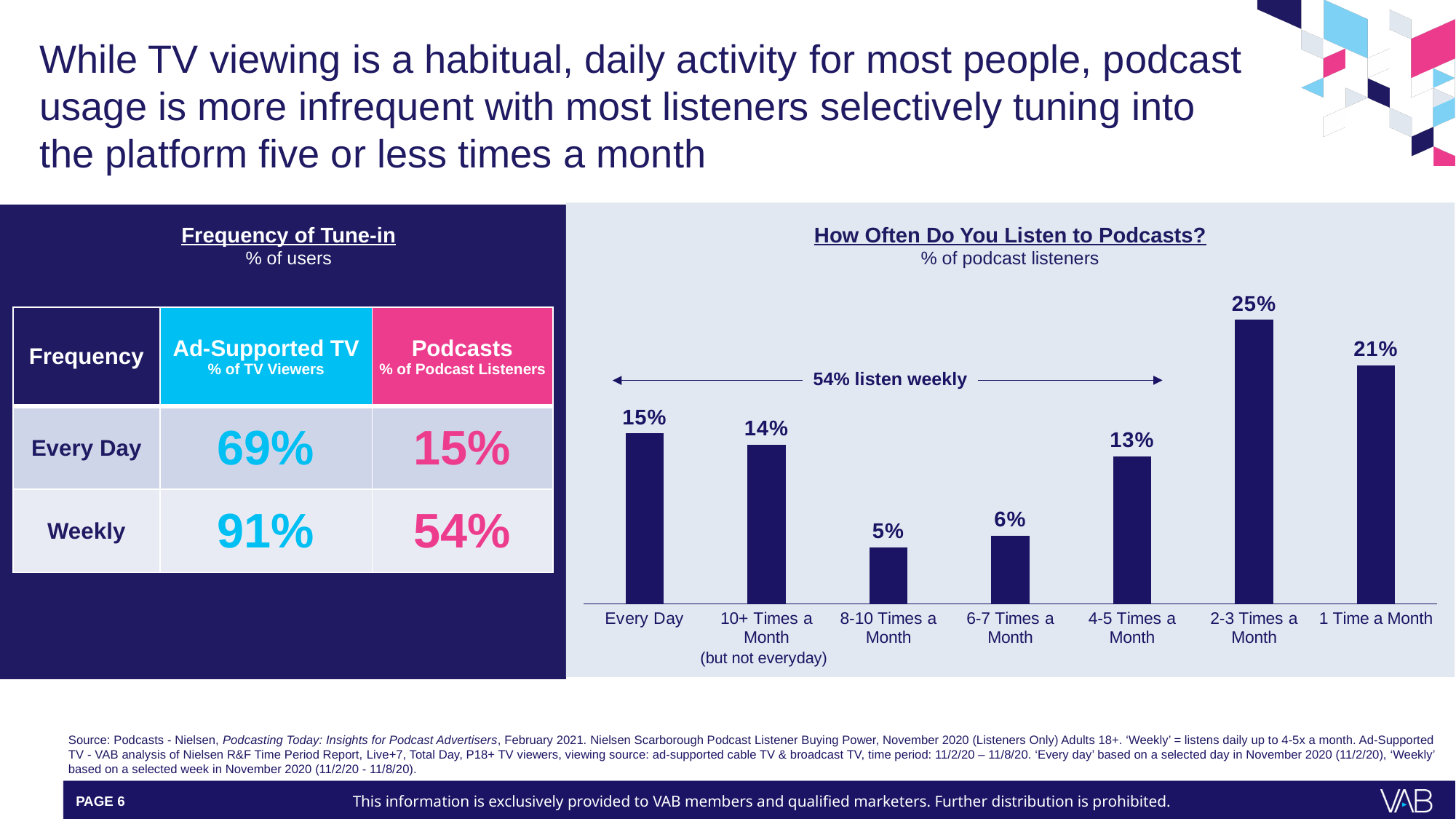
What type of chart is 'How Often Do You Listen to Podcasts?'? Bar chart In the 'How Often Do You Listen to Podcasts?' chart, which is larger: the value for '6-7 Times a Month' or '4-5 Times a Month'? 4-5 Times a Month In the 'How Often Do You Listen to Podcasts?' chart, what is the difference between the values for '2-3 Times a Month' and '1 Time a Month'? 4% How many categories are shown in the 'How Often Do You Listen to Podcasts?' chart? 7 In the 'How Often Do You Listen to Podcasts?' chart, what is the difference between the values for 'Every Day' and '8-10 Times a Month'? 10% In the 'How Often Do You Listen to Podcasts?' chart, which category has the lowest value? 8-10 Times a Month In the 'How Often Do You Listen to Podcasts?' chart, which category has the highest value? 2-3 Times a Month In the 'How Often Do You Listen to Podcasts?' chart, what is the value for '4-5 Times a Month'? 13% In the 'How Often Do You Listen to Podcasts?' chart, what percentage of podcast listeners listen every day? 15% According to the annotation on the 'How Often Do You Listen to Podcasts?' chart, what percentage of podcast listeners listen weekly? 54% In the 'How Often Do You Listen to Podcasts?' chart, what is the value for '2-3 Times a Month'? 25% In the 'How Often Do You Listen to Podcasts?' chart, which is larger: the value for 'Every Day' or '1 Time a Month'? 1 Time a Month